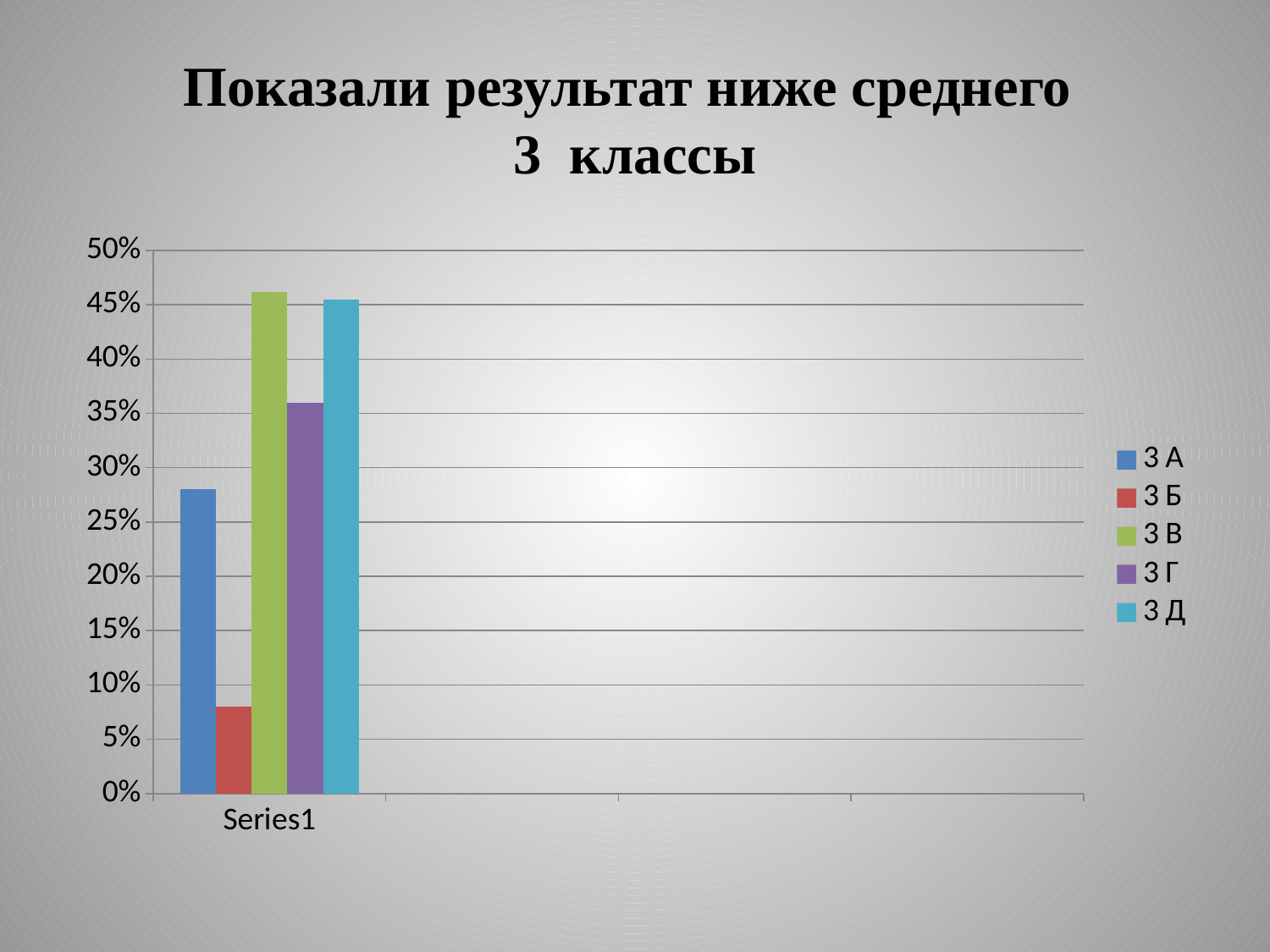
Is the value for 3 В greater or less than 40%? greater Which series has the lowest value? 3 Б Is the value for 3 Д greater or less than 40%? greater Is the value for 3 А greater or less than 30%? less Which is larger, the value for 3 А or the value for 3 Г? 3 Г What is the title of the slide? Показали результат ниже среднего 3 классы Which is larger, the value for 3 Б or the value for 3 А? 3 А What kind of chart is shown on the slide? bar chart How many series does the legend list? 5